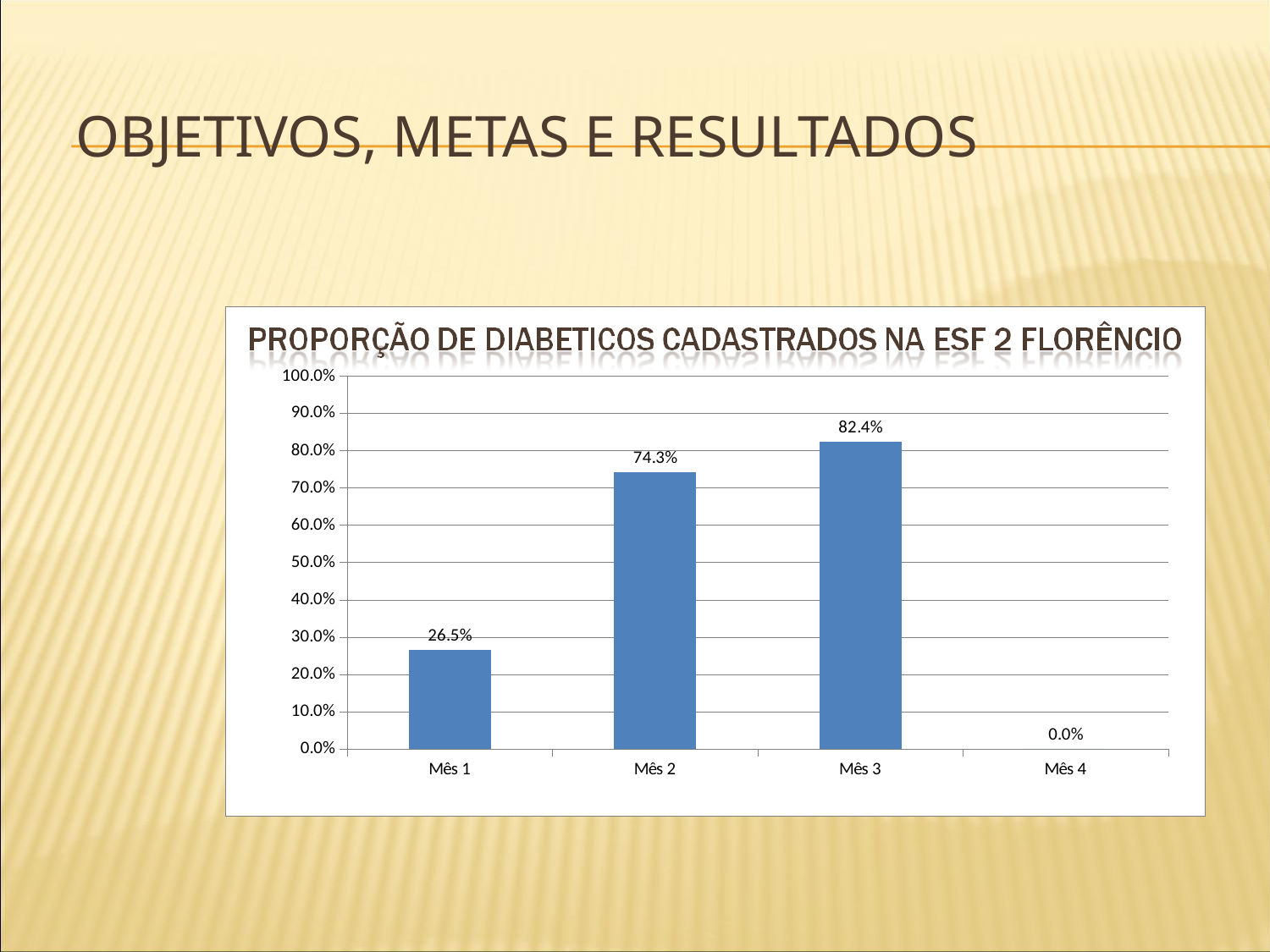
Which month has the highest value? Mês 3 What kind of chart is shown on the slide? Bar chart What is the value for Mês 2? 74.3% What is the difference between the values for Mês 2 and Mês 1? 47.8% What is the value for Mês 1? 26.5% What is the value for Mês 3? 82.4% How many months are shown on the x axis? 4 What is the difference between the values for Mês 3 and Mês 2? 8.1% Which is larger, the value for Mês 1 or the value for Mês 2? Mês 2 What is the title of the chart? PROPORÇÃO DE DIABETICOS CADASTRADOS NA ESF 2 FLORÊNCIO Which month has the lowest value? Mês 4 What is the value for Mês 4? 0.0%